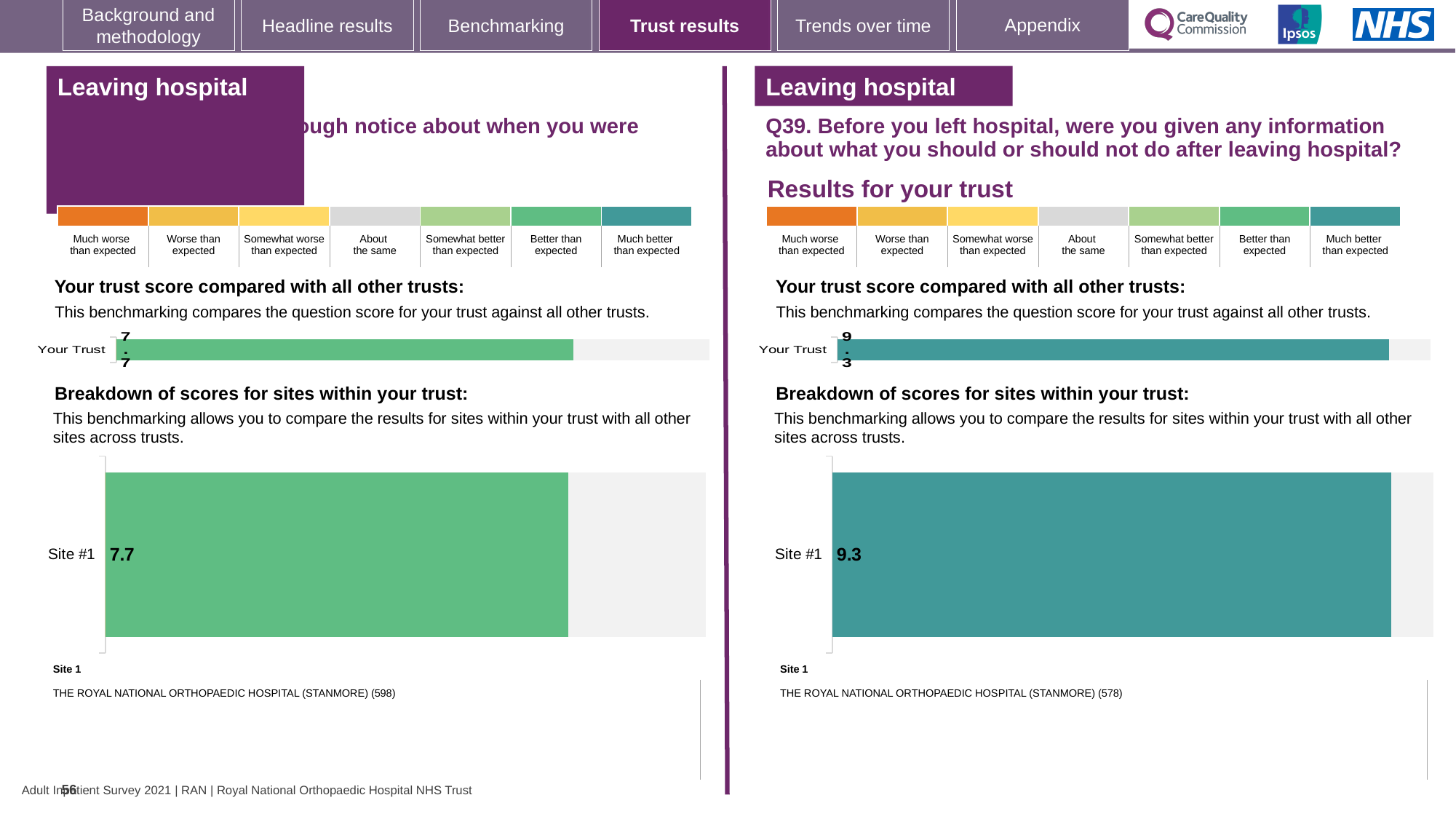
Which site name is listed as Site 1 below the right-hand breakdown chart (Q39)? THE ROYAL NATIONAL ORTHOPAEDIC HOSPITAL (STANMORE) (578) What colour is the Site #1 bar in the left-hand 'Breakdown of scores for sites within your trust' chart? Green Which is larger: the Site #1 score in the left-hand breakdown chart or the Site #1 score in the right-hand breakdown chart (Q39)? The right-hand (Q39) Site #1 score How many sites are shown in the right-hand 'Breakdown of scores for sites within your trust' chart (Q39)? 1 What colour is the Site #1 bar in the right-hand 'Breakdown of scores for sites within your trust' chart (Q39)? Teal On the right-hand side of the slide (Q39), what is the score shown for Your Trust in the 'Your trust score compared with all other trusts' chart? 9.3 How many sites are shown in the left-hand 'Breakdown of scores for sites within your trust' chart? 1 What type of chart is used for the 'Breakdown of scores for sites within your trust' on the right-hand side (Q39)? Bar chart In the left-hand 'Breakdown of scores for sites within your trust' chart, what is the score for Site #1? 7.7 What is the difference between the Site #1 score in the right-hand breakdown chart (Q39) and the Site #1 score in the left-hand breakdown chart? 1.6 On the left-hand side of the slide, what is the score shown for Your Trust in the 'Your trust score compared with all other trusts' chart? 7.7 In the right-hand 'Breakdown of scores for sites within your trust' chart (Q39), what is the score for Site #1? 9.3